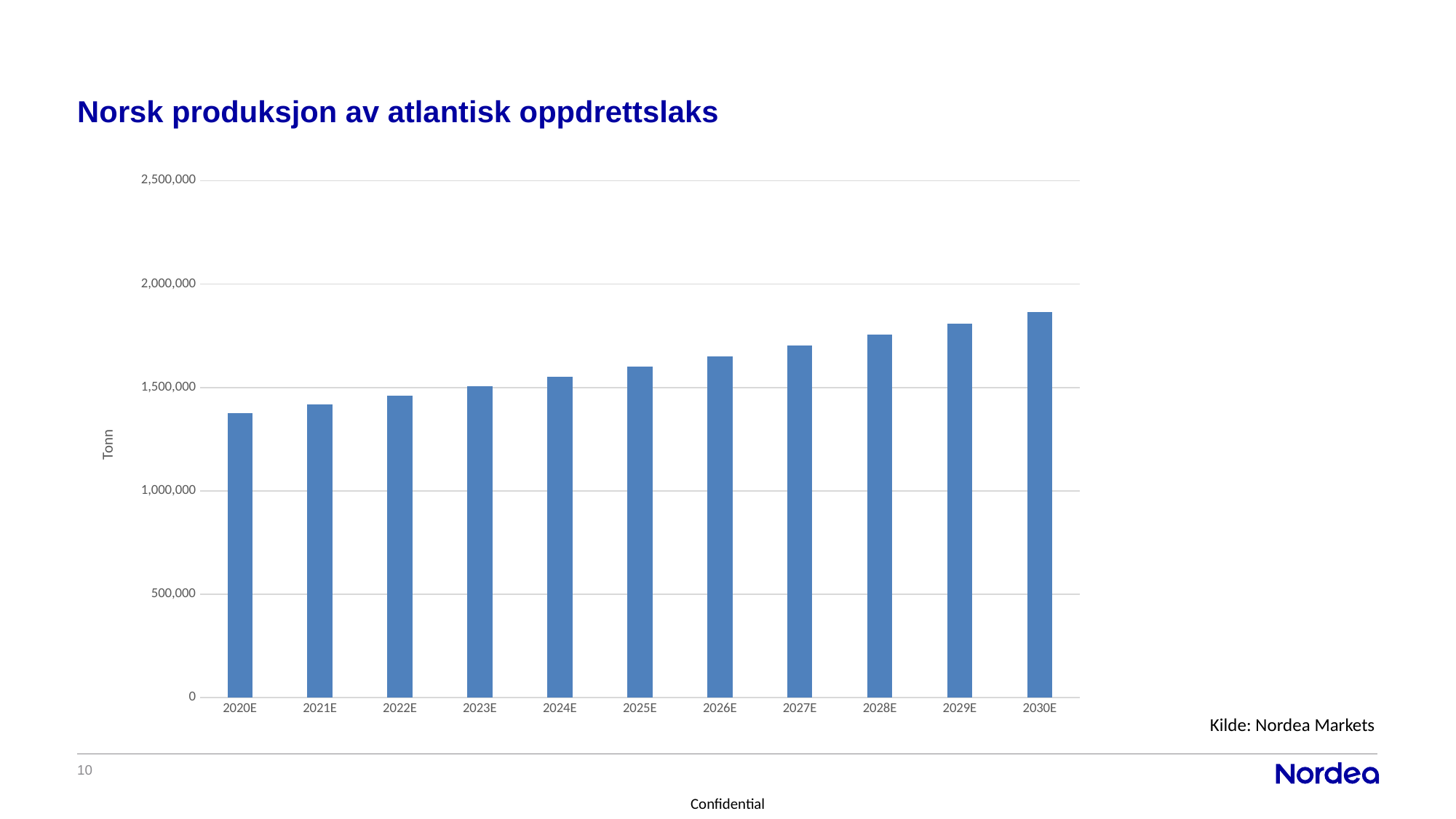
Is the value for 2021E greater or less than 1,000,000? greater What unit is shown on the vertical axis of the chart? Tonn Which is larger, the value for 2024E or the value for 2029E? 2029E Do the values rise or fall from 2020E to 2030E? Rise What is the title of the chart? Norsk produksjon av atlantisk oppdrettslaks Which year has the lowest production in the chart? 2020E Is the value for 2030E greater or less than 2,000,000? less Which year has the highest production in the chart? 2030E Is the value for 2020E greater or less than 1,500,000? less What kind of chart is shown on the slide? Bar chart How many years (bars) are shown in the chart? 11